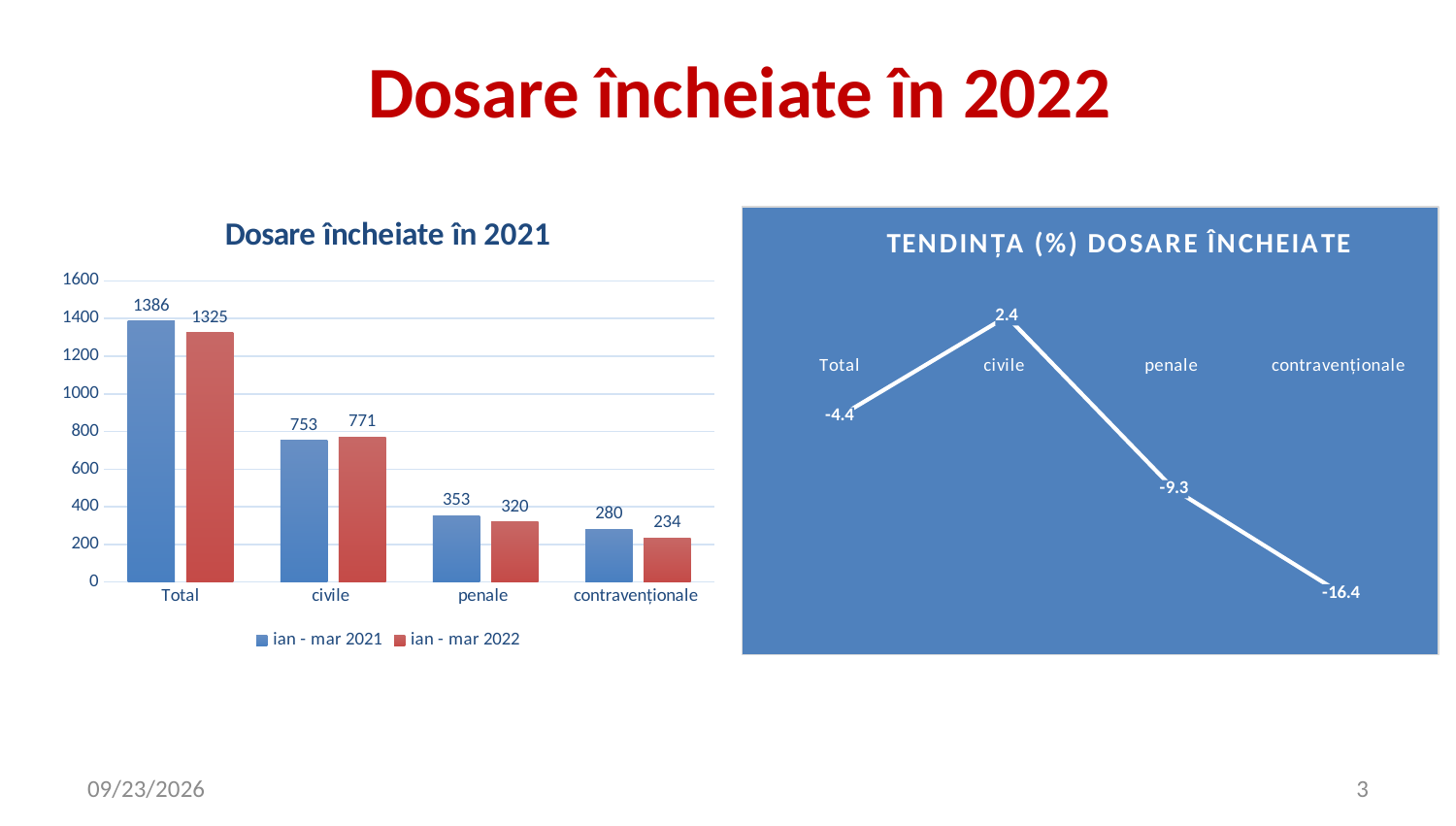
What kind of chart is the chart titled 'Dosare încheiate în 2021'? bar chart In the chart titled 'TENDINȚA (%) DOSARE ÎNCHEIATE', which category has the highest value? civile In the chart titled 'Dosare încheiate în 2021', which is larger for 'civile': the 'ian - mar 2021' value or the 'ian - mar 2022' value? ian - mar 2022 In the chart titled 'Dosare încheiate în 2021', what is the difference between the 'ian - mar 2021' and 'ian - mar 2022' values for 'Total'? 61 In the chart titled 'Dosare încheiate în 2021', how many categories are shown on the x axis? 4 In the chart titled 'Dosare încheiate în 2021', what is the value for 'civile' in the 'ian - mar 2022' series? 771 In the chart titled 'Dosare încheiate în 2021', which category has the lowest value in the 'ian - mar 2022' series? contravenționale What kind of chart is the chart titled 'TENDINȚA (%) DOSARE ÎNCHEIATE'? line chart In the chart titled 'TENDINȚA (%) DOSARE ÎNCHEIATE', which category has the lowest value? contravenționale In the chart titled 'TENDINȚA (%) DOSARE ÎNCHEIATE', what is the value for 'penale'? -9.3 In the chart titled 'Dosare încheiate în 2021', what is the value for 'penale' in the 'ian - mar 2021' series? 353 In the chart titled 'Dosare încheiate în 2021', how many series does the legend list? 2